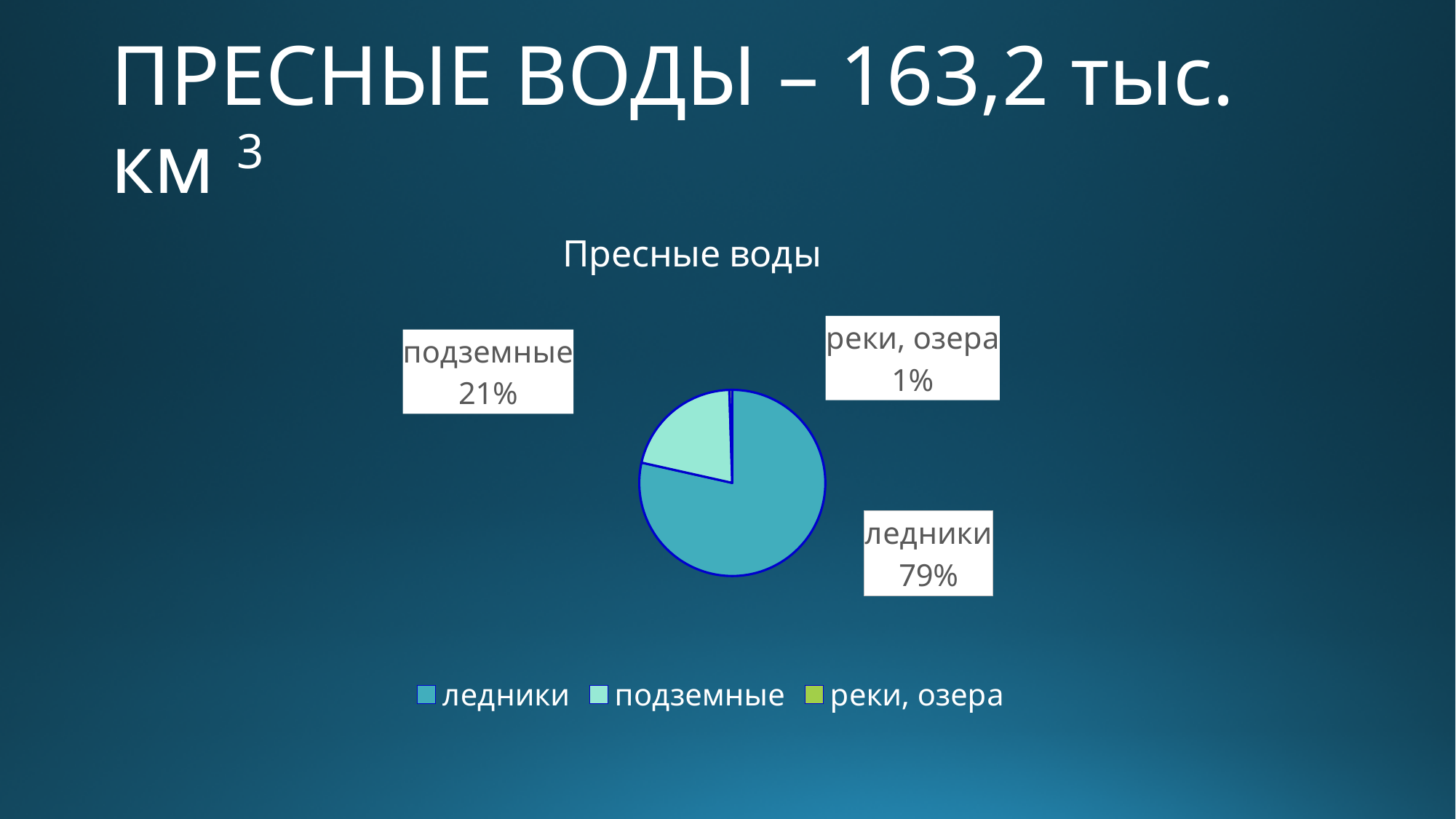
What share of the pie does ледники have? 79% What is the title of the chart? Пресные воды Which category has the largest slice of the pie? ледники Which category has the smallest slice of the pie? реки, озера What is the difference in percentage points between ледники and подземные? 58 How many categories are shown in the pie chart? 3 What kind of chart is shown on the slide? pie chart How many entries does the legend list? 3 What share of the pie does подземные have? 21% What is the difference in percentage points between подземные and реки, озера? 20 Which is larger, the share for подземные or the share for реки, озера? подземные What share of the pie does реки, озера have? 1%